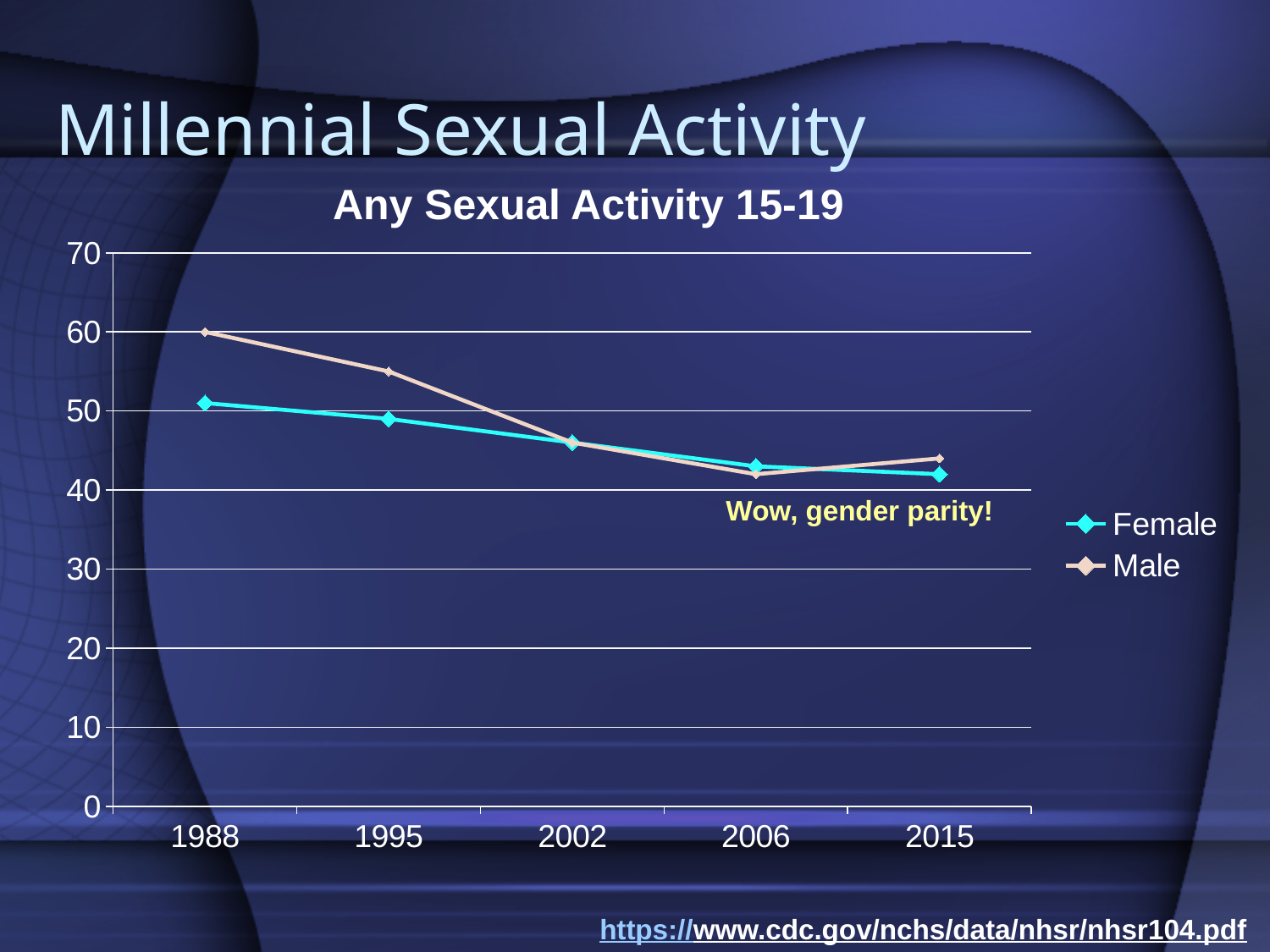
How many years are plotted along the x axis? 5 Is the value for Male in 2006 greater or less than 50? less What is the value for Male in 1988? 60 In 1988, which is larger, the Male value or the Female value? Male How many series does the legend list? 2 What is the title of the chart? Any Sexual Activity 15-19 Does the Male series generally rise or fall from 1988 to 2006? fall What kind of chart is shown on the slide? line chart In which year is the Male series at its highest? 1988 Which series is drawn in the cyan line? Female Is the value for Female in 1988 greater or less than 50? greater In which year is the Female series at its lowest? 2015